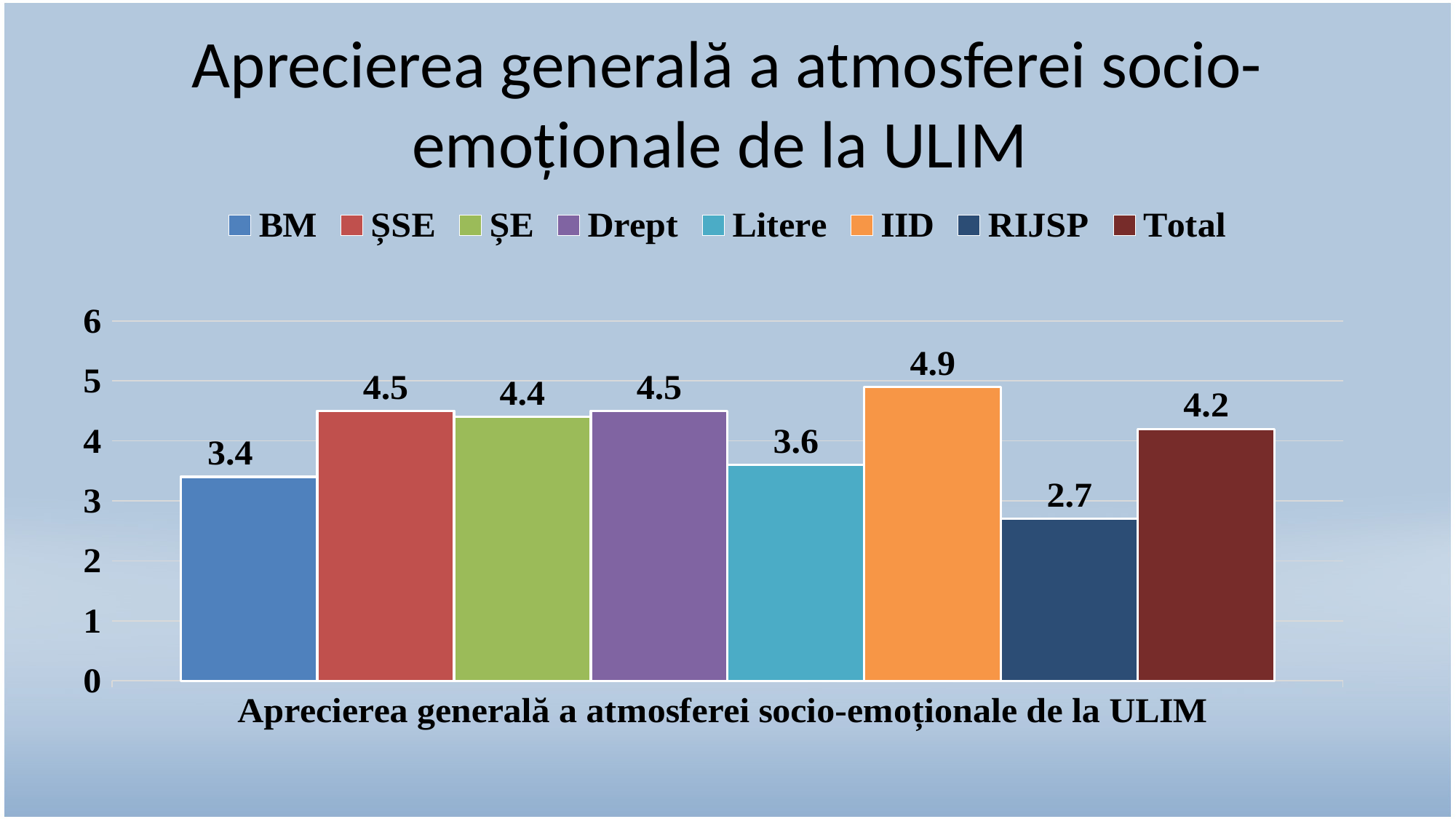
What is the value for RIJSP? 2.7 How many series does the legend list? 8 Which series has the lowest value? RIJSP Is the value for BM greater or less than 3? greater What is the value for Litere? 3.6 Which is larger, the value for Litere or the value for Drept? Drept What kind of chart is shown on the slide? bar chart What is the difference between the values for ȘSE and BM? 1.1 What is the value for Total? 4.2 Which series has the highest value? IID What is the difference between the values for IID and RIJSP? 2.2 What is the value for IID? 4.9